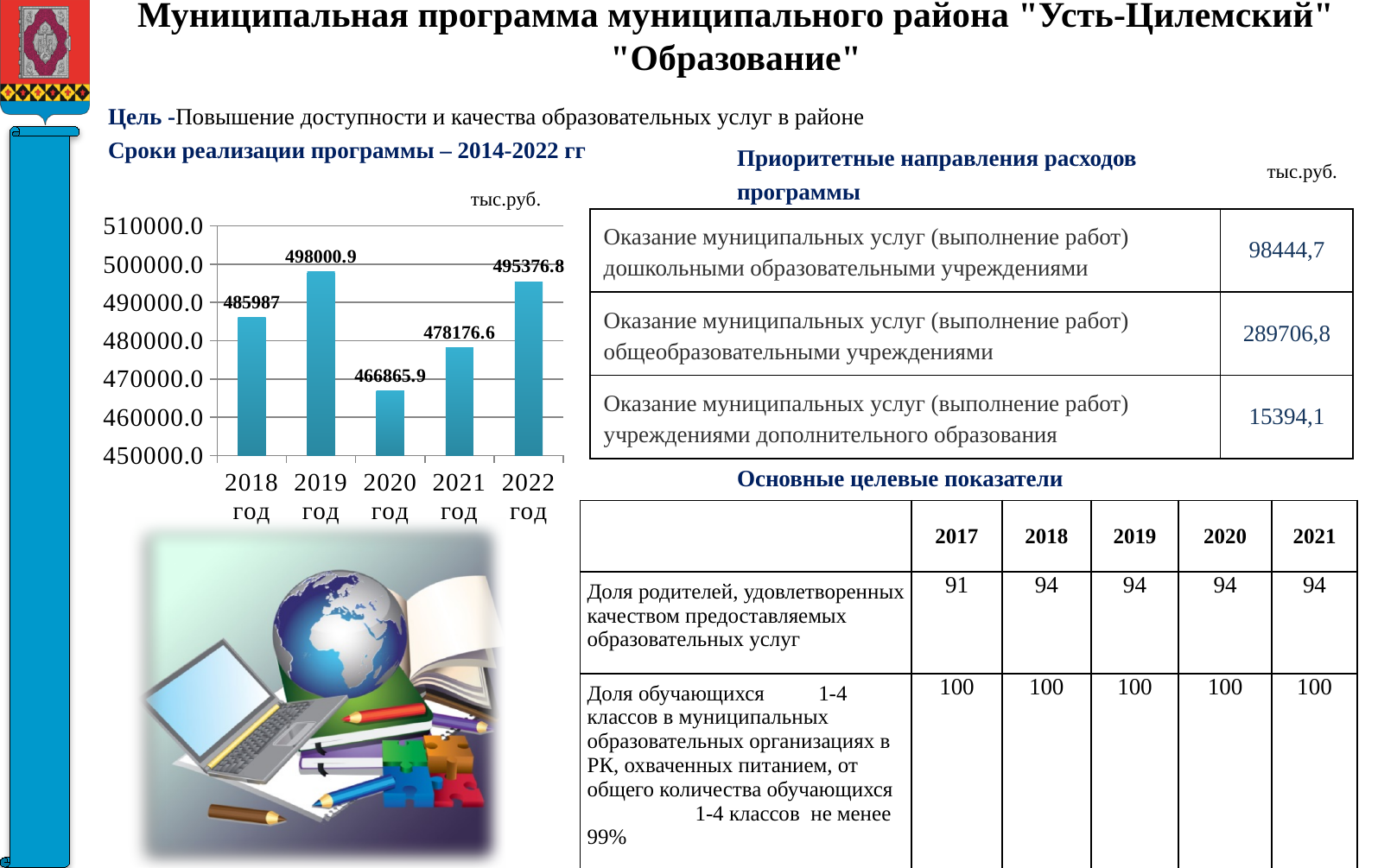
Which year has the highest value in the bar chart? 2019 год What is the difference between the values for 2022 год and 2021 год in the bar chart? 17200.2 What is the difference between the values for 2019 год and 2020 год in the bar chart? 31135.0 What is the value for 2020 год in the bar chart? 466865.9 Which is larger in the bar chart, the value for 2021 год or the value for 2022 год? 2022 год What is the value for 2018 год in the bar chart? 485987 What unit is indicated above the bar chart? тыс.руб. How many years are shown on the x axis of the bar chart? 5 What kind of chart is shown on the slide? bar chart Is the value for 2018 год in the bar chart greater or less than 480000.0? greater What is the value for 2019 год in the bar chart? 498000.9 Which year has the lowest value in the bar chart? 2020 год